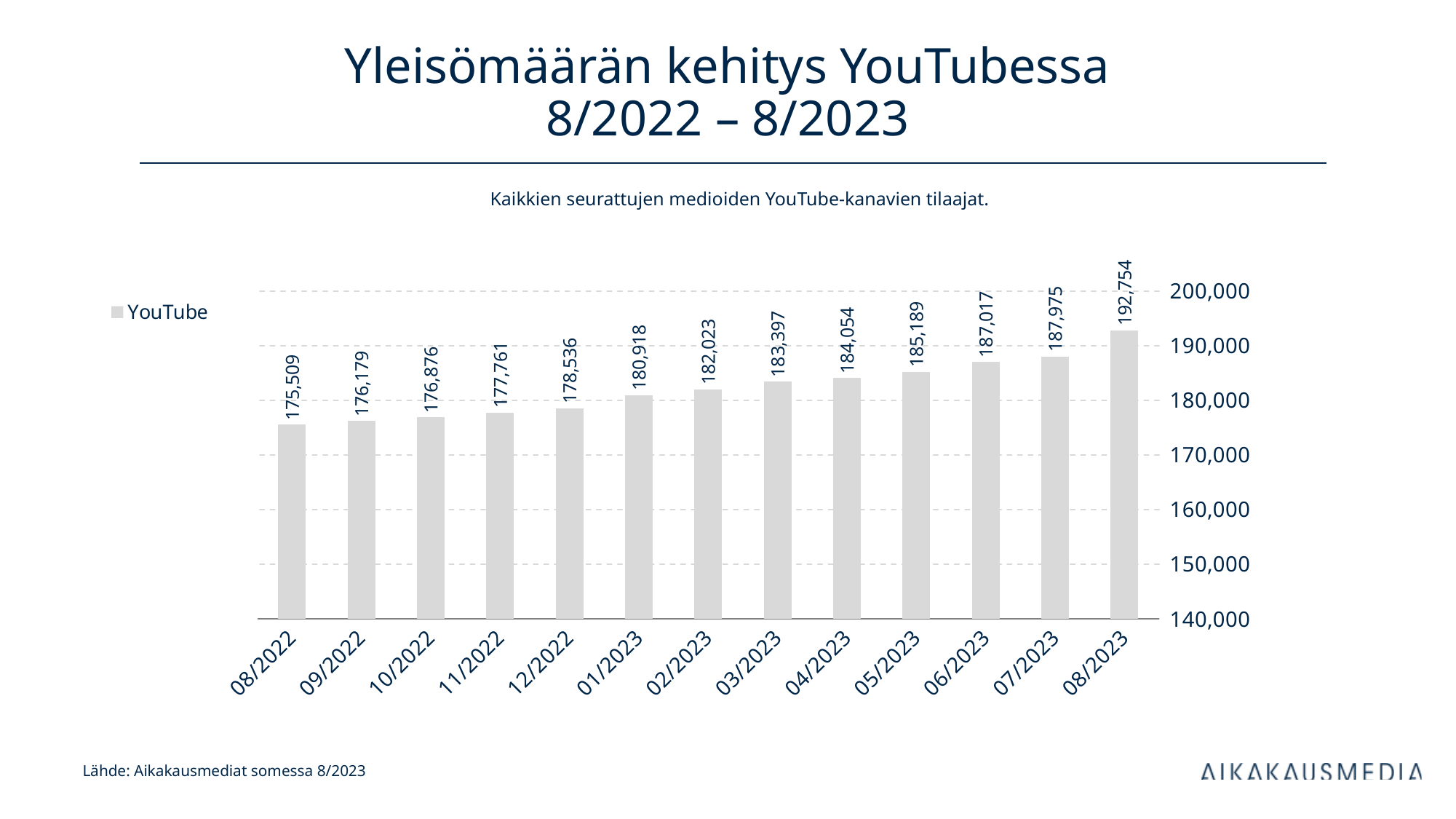
What kind of chart is shown? bar chart What is the value for 08/2022? 175,509 What is the difference between the values for 08/2023 and 08/2022? 17,245 What is the difference between the values for 07/2023 and 06/2023? 958 Is the value for 05/2023 greater or less than 180,000? greater Do the values rise or fall from 08/2022 to 08/2023? rise Which month has the lowest value? 08/2022 Which month has the highest value? 08/2023 How many months are shown on the x axis? 13 What is the value for 01/2023? 180,918 Which is larger, the value for 03/2023 or the value for 12/2022? 03/2023 What is the value for 08/2023? 192,754